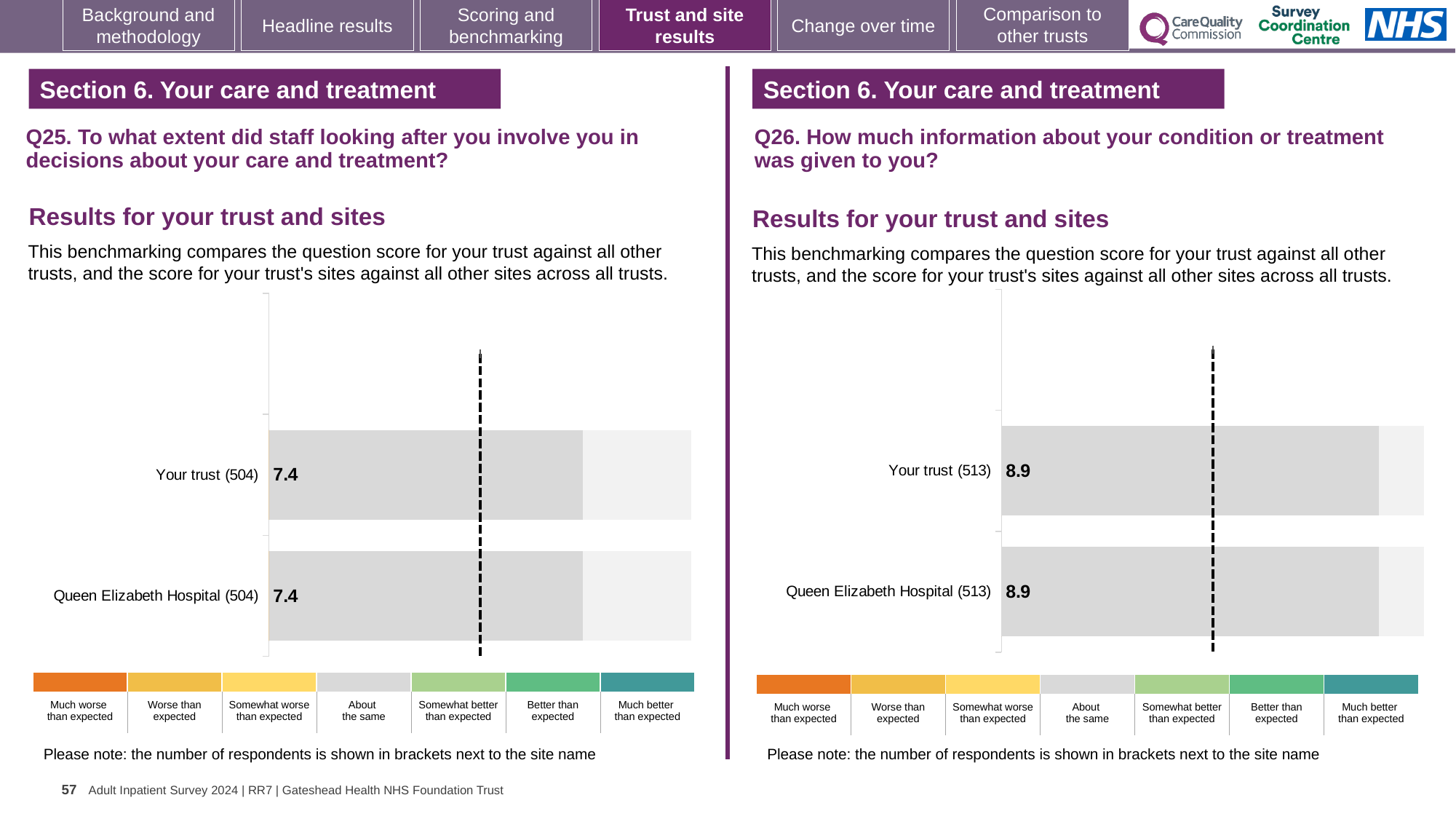
On the Q26 chart (right), how many respondents are shown in brackets next to Queen Elizabeth Hospital? 513 What kind of chart is the Q26 chart (right)? Bar chart On the Q25 chart (left), how many respondents are shown in brackets next to Your trust? 504 On the Q25 chart (left), what is the difference between the Your trust score and the Queen Elizabeth Hospital score? 0 On the Q26 chart (right), what is the score for Queen Elizabeth Hospital? 8.9 On the Q25 chart (left), what is the score for Queen Elizabeth Hospital? 7.4 How many bars are plotted on the Q26 chart (right)? 2 On the Q26 chart (right), what is the score for Your trust? 8.9 On the Q25 chart (left), what is the score for Your trust? 7.4 On the Q26 chart (right), what is the difference between the Your trust score and the Queen Elizabeth Hospital score? 0 How many bars are plotted on the Q25 chart (left)? 2 Is the Your trust score on the Q26 chart (right) larger or smaller than the Your trust score on the Q25 chart (left)? Larger